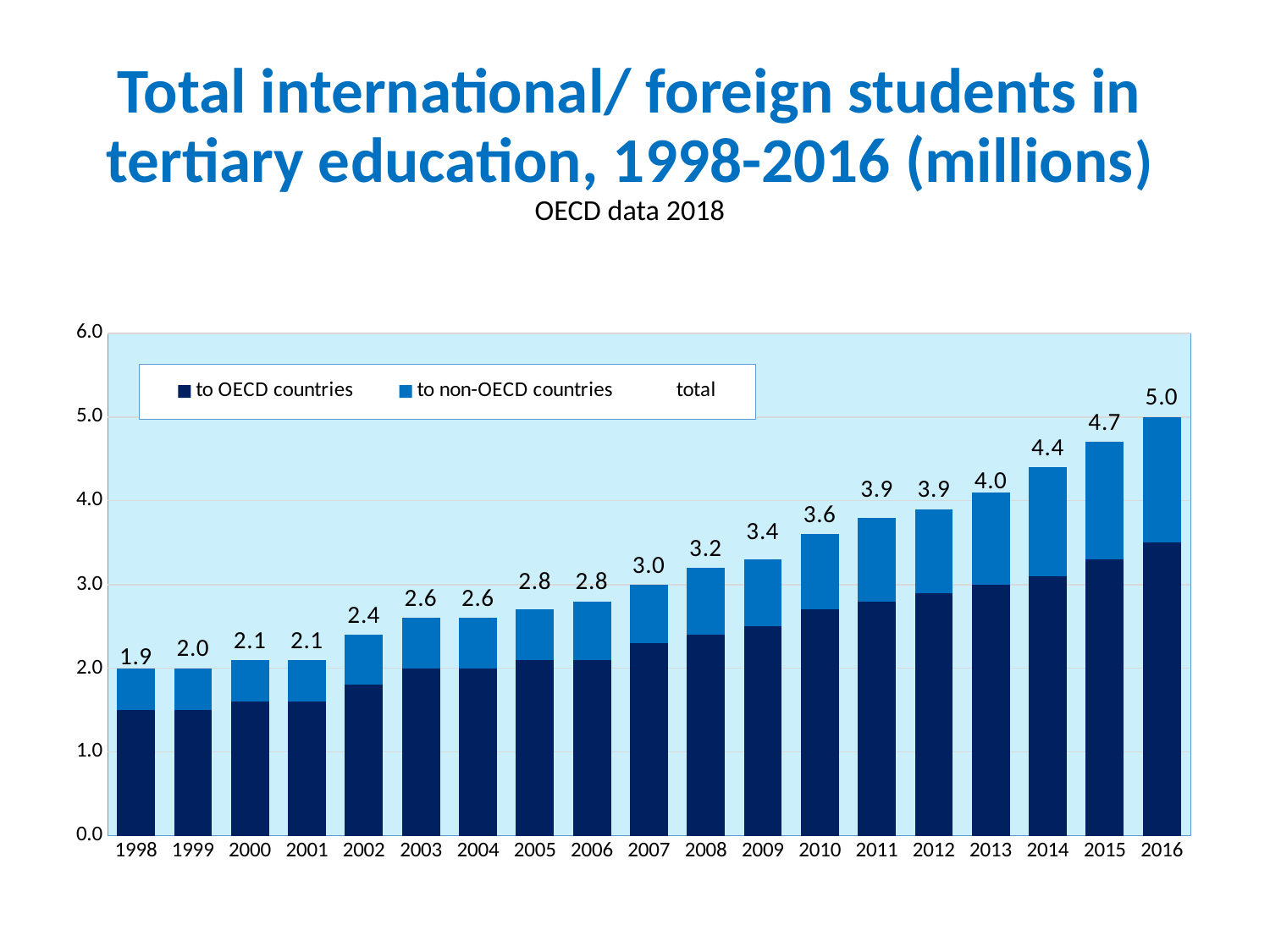
What is the total number of international/foreign students shown for 2016? 5.0 What is the difference between the total for 2016 and the total for 1998? 3.1 What is the difference between the total for 2014 and the total for 2010? 0.8 Do the totals rise or fall from 1998 to 2016? rise Which year has the lowest total? 1998 What is the total value labelled for 2002? 2.4 Which year has the highest total? 2016 How many entries does the legend list? 3 How many years are shown on the x axis? 19 Which is larger, the total for 2005 or the total for 2009? 2009 Is the value for 'to OECD countries' in 2016 greater or less than 3.0? greater What is the total value labelled for 2008? 3.2